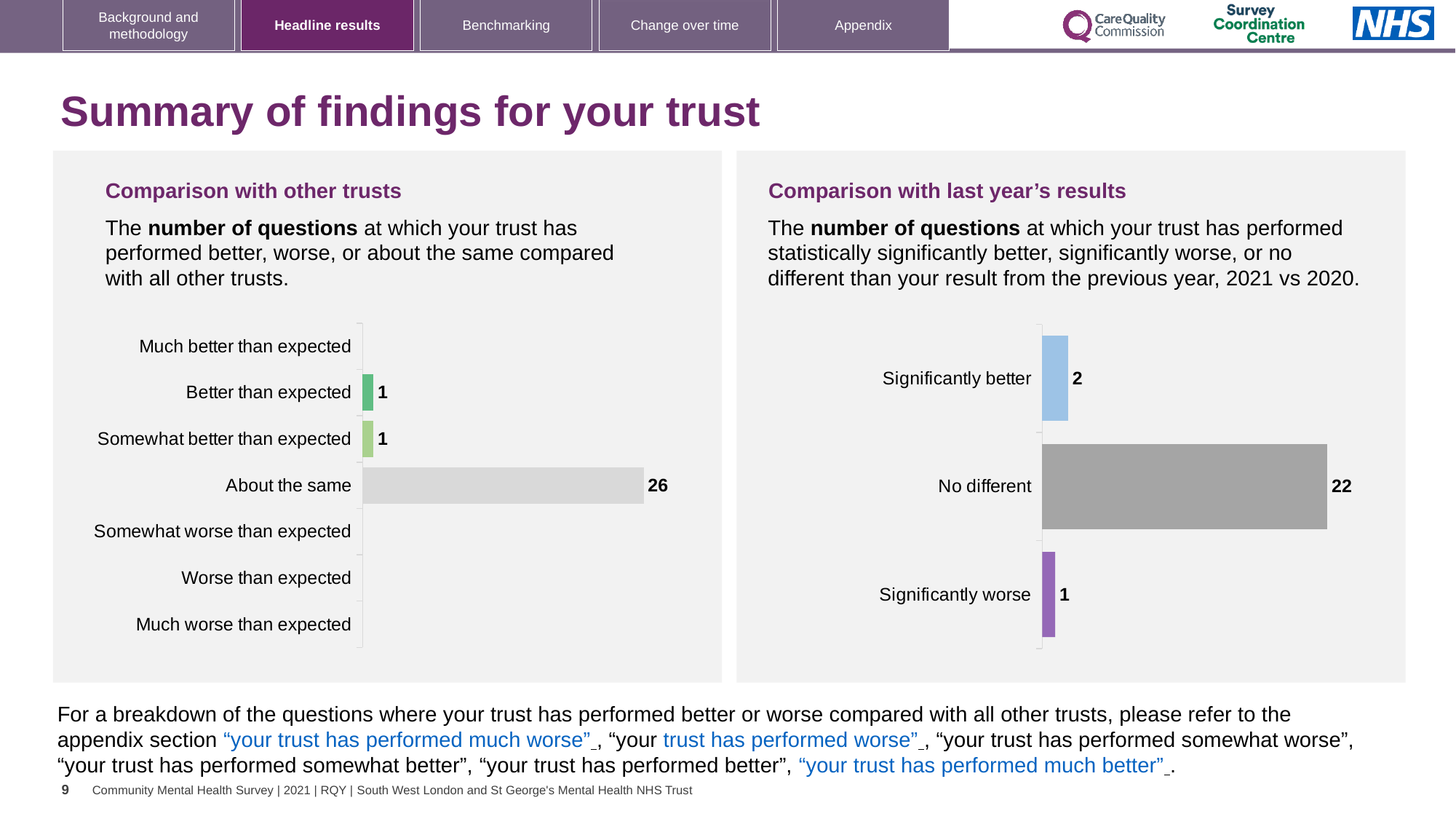
In the 'Comparison with other trusts' chart, how many questions are 'About the same'? 26 In the 'Comparison with last year's results' chart, how many categories are shown? 3 In the 'Comparison with last year's results' chart, what is the total of all three categories? 25 In the 'Comparison with last year's results' chart, how many questions are 'Significantly better'? 2 In the 'Comparison with other trusts' chart, which category has the highest value? About the same In the 'Comparison with last year's results' chart, how many questions are 'No different'? 22 In the 'Comparison with last year's results' chart, which category has the lowest value? Significantly worse In the 'Comparison with other trusts' chart, how many categories are listed on the axis? 7 What kind of chart is the 'Comparison with other trusts' chart? Bar chart In the 'Comparison with last year's results' chart, which is larger: 'Significantly better' or 'Significantly worse'? Significantly better In the 'Comparison with other trusts' chart, what is the difference between 'About the same' and 'Somewhat better than expected'? 25 In the 'Comparison with other trusts' chart, how many questions are 'Better than expected'? 1